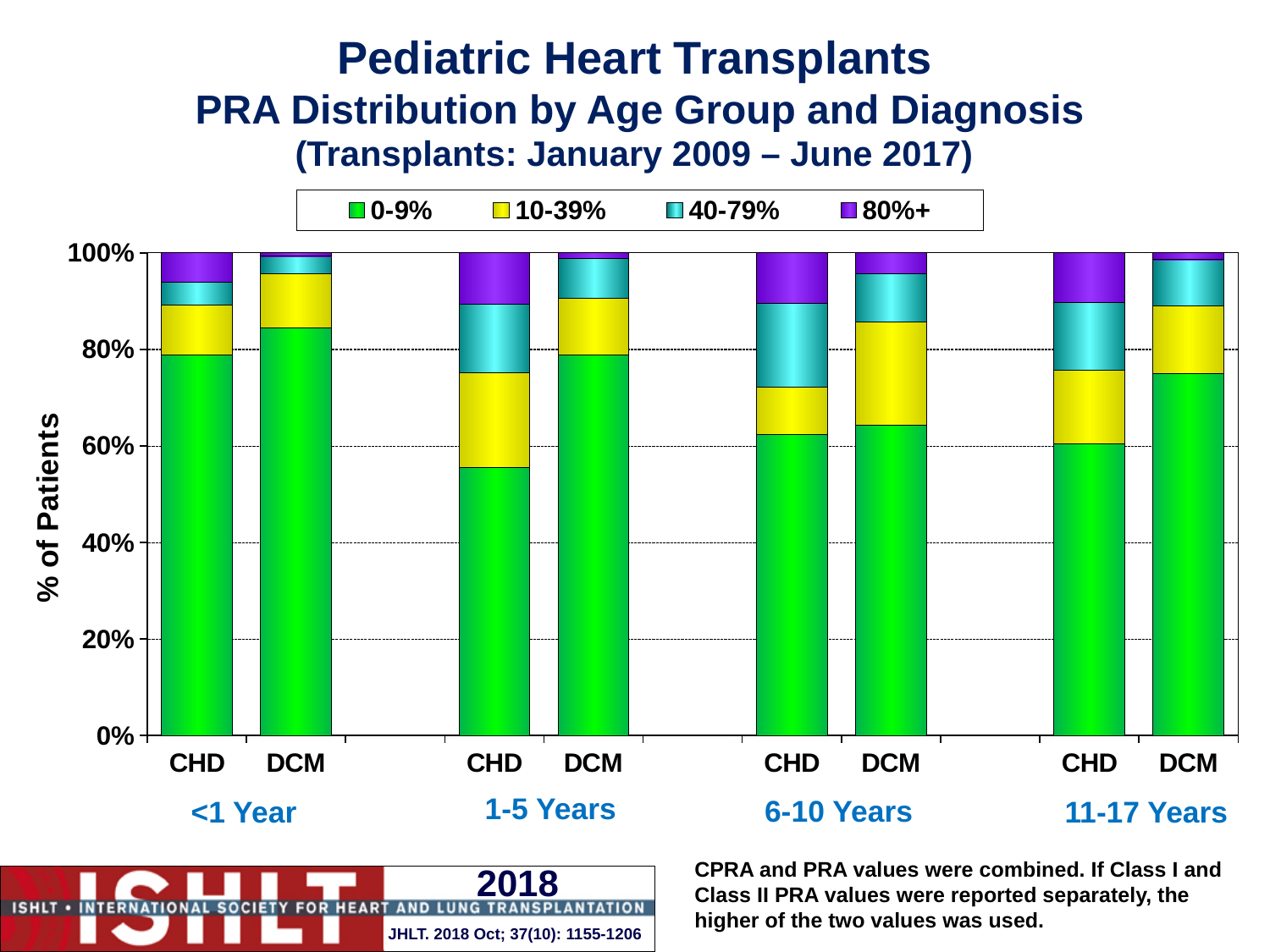
Is the 0-9% share for DCM in the 11-17 Years group greater or less than 60%? greater How many age groups are shown along the x axis? 4 In the <1 Year group, which diagnosis has the larger 0-9% share, CHD or DCM? DCM Which bar has the largest 0-9% segment? DCM, <1 Year How many bars are plotted in the chart? 8 In the 1-5 Years group, which diagnosis has the larger 0-9% share, CHD or DCM? DCM What kind of chart is shown on the slide? Stacked bar chart Is the 0-9% share for DCM in the <1 Year group greater or less than 80%? greater Which PRA category is shown in green in the legend? 0-9% Is the 0-9% share for CHD in the 1-5 Years group greater or less than 60%? less What is the label on the y axis? % of Patients How many series does the legend list? 4